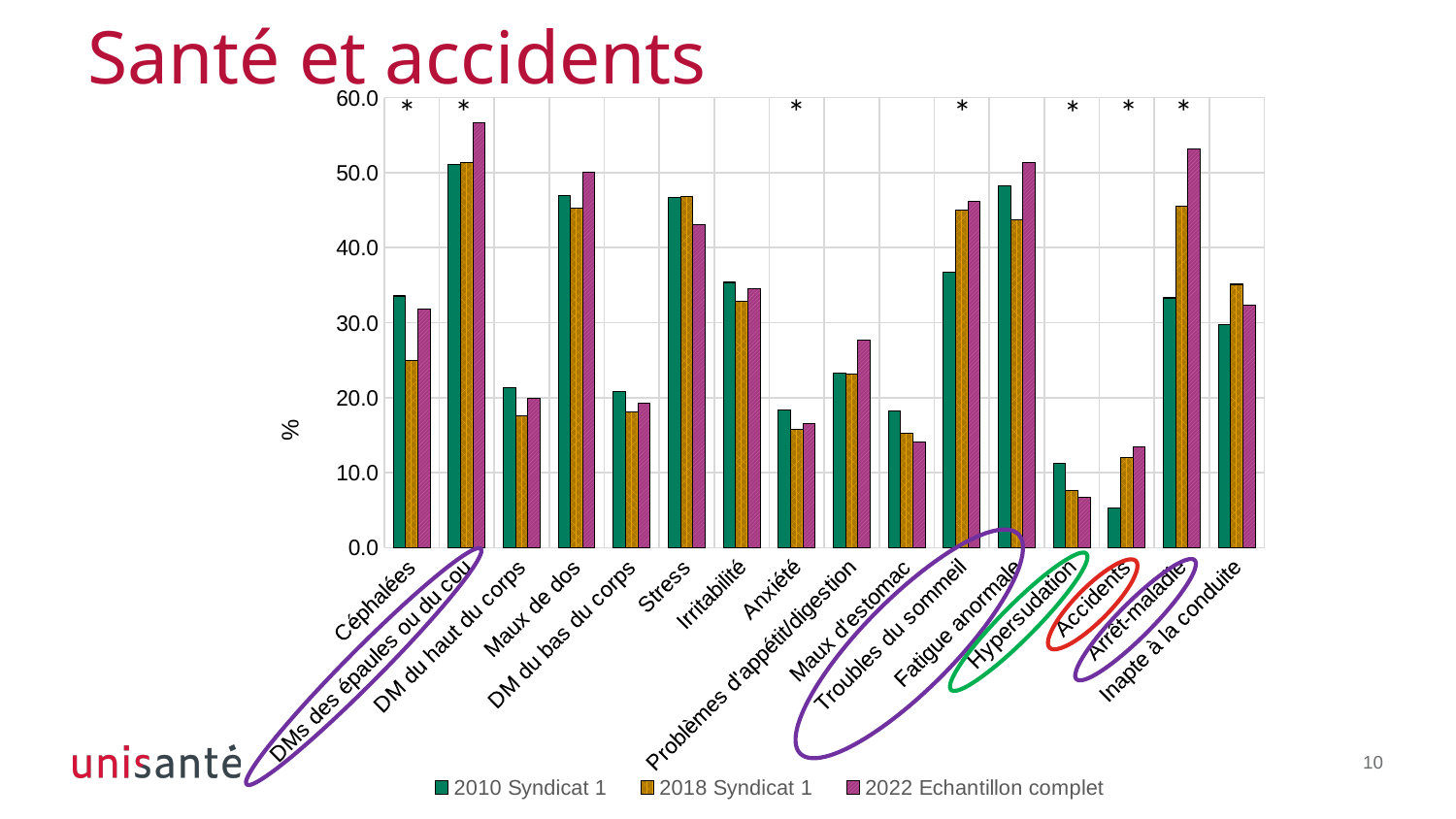
Is the value for Arrêt-maladie in the 2022 Echantillon complet series greater or less than 50? greater Is the value for Hypersudation in the 2022 Echantillon complet series greater or less than 10? less Is the value for Céphalées in the 2010 Syndicat 1 series greater or less than 30? greater How many categories are shown along the x axis? 16 What is the label of the y axis? % How many series does the legend list? 3 Which category has the lowest value in the 2010 Syndicat 1 series? Accidents What kind of chart is shown on the slide? bar chart For Arrêt-maladie, which is larger: the 2010 Syndicat 1 value or the 2018 Syndicat 1 value? 2018 Syndicat 1 Which series is shown in purple according to the legend? 2022 Echantillon complet Which category has the highest value in the 2022 Echantillon complet series? DMs des épaules ou du cou